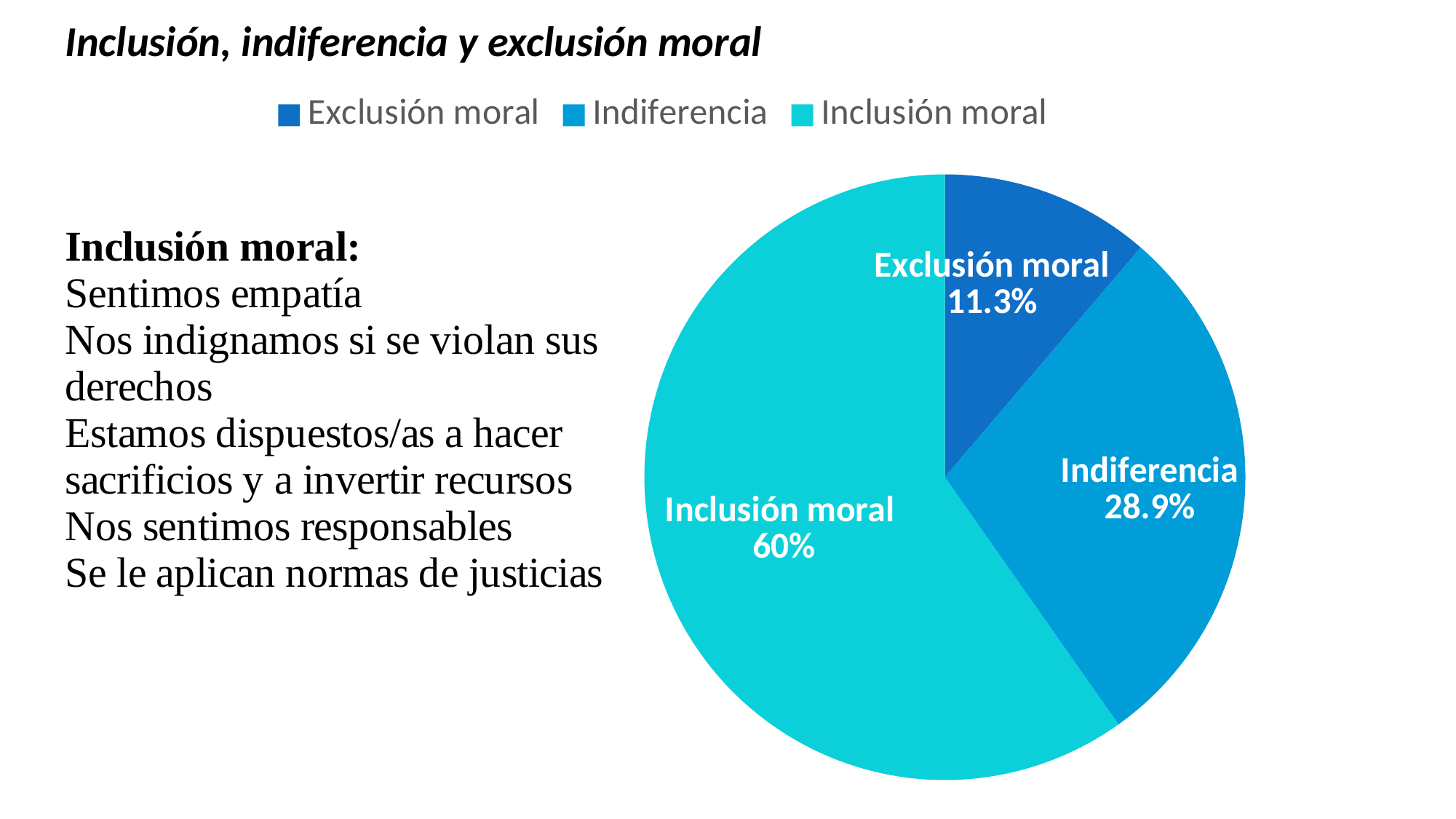
How many entries does the legend list? 3 What is the title of the chart? Inclusión, indiferencia y exclusión moral Which category has the smallest slice of the pie? Exclusión moral Which category has the largest slice of the pie? Inclusión moral What is the difference between the values for Indiferencia and Exclusión moral? 17.6% How many categories are shown in the pie chart? 3 What share of the pie does Inclusión moral have? 60% What is the value shown for Indiferencia? 28.9% What kind of chart is shown on the slide? pie chart What is the difference between the values for Inclusión moral and Indiferencia? 31.1% What is the value shown for Exclusión moral? 11.3% Which is larger, Indiferencia or Exclusión moral? Indiferencia